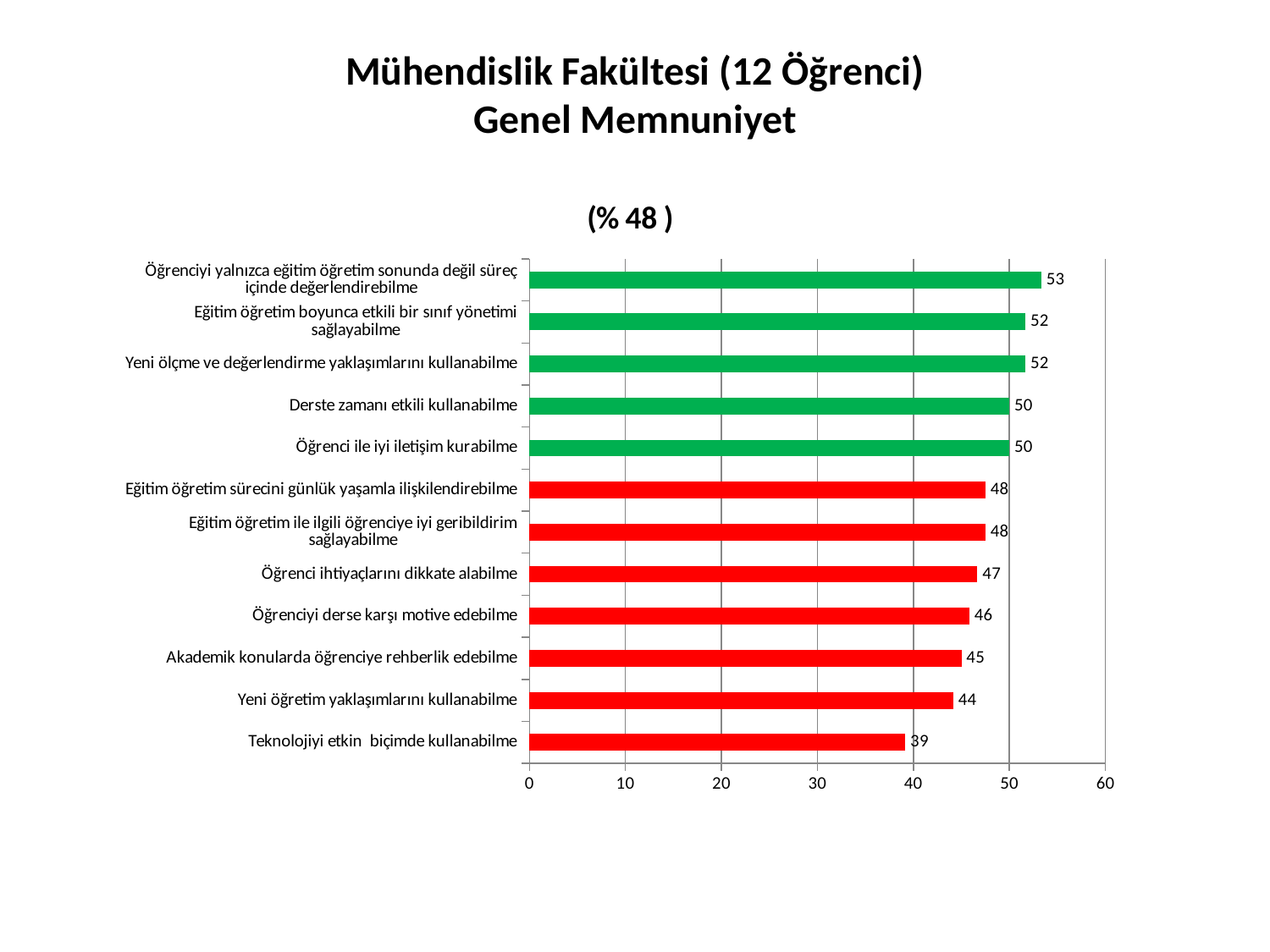
What kind of chart is shown on the slide? bar chart What is the value for "Derste zamanı etkili kullanabilme"? 50 What is the chart's title? (% 48 ) How many categories are shown in the chart? 12 Which is larger: "Öğrenci ihtiyaçlarını dikkate alabilme" or "Yeni öğretim yaklaşımlarını kullanabilme"? Öğrenci ihtiyaçlarını dikkate alabilme What is the value for "Teknolojiyi etkin biçimde kullanabilme"? 39 What is the difference between "Akademik konularda öğrenciye rehberlik edebilme" and "Yeni öğretim yaklaşımlarını kullanabilme"? 1 Is the value for "Yeni ölçme ve değerlendirme yaklaşımlarını kullanabilme" greater or less than 50? greater What is the value for "Öğrenciyi derse karşı motive edebilme"? 46 Which category has the highest value? Öğrenciyi yalnızca eğitim öğretim sonunda değil süreç içinde değerlendirebilme What is the difference between the highest value (53) and the lowest value (39)? 14 Which category has the lowest value? Teknolojiyi etkin biçimde kullanabilme